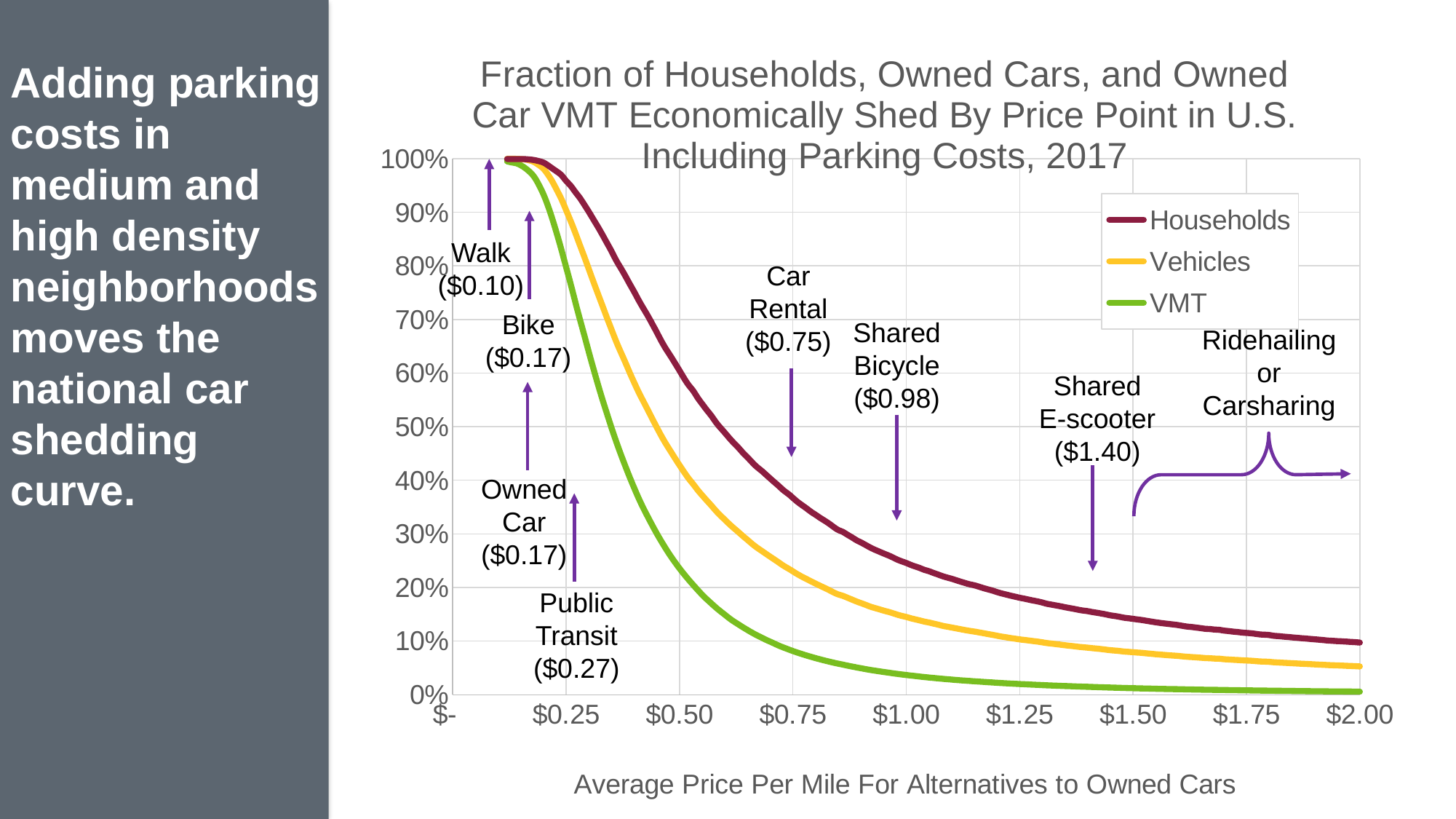
Is the Households value at $0.50 greater or less than 50%? greater At $1.00, which series has the higher value, Households or VMT? Households Which series has the lowest value at $1.50? VMT What kind of chart is shown on the slide? Line chart Is the VMT value at $0.50 greater or less than 40%? less What is the title of the x axis? Average Price Per Mile For Alternatives to Owned Cars Do the values of the Households series rise or fall as the price per mile increases? Fall Is the Households value at $1.00 greater or less than 20%? greater Which series does the legend list first? Households How many series does the legend list? 3